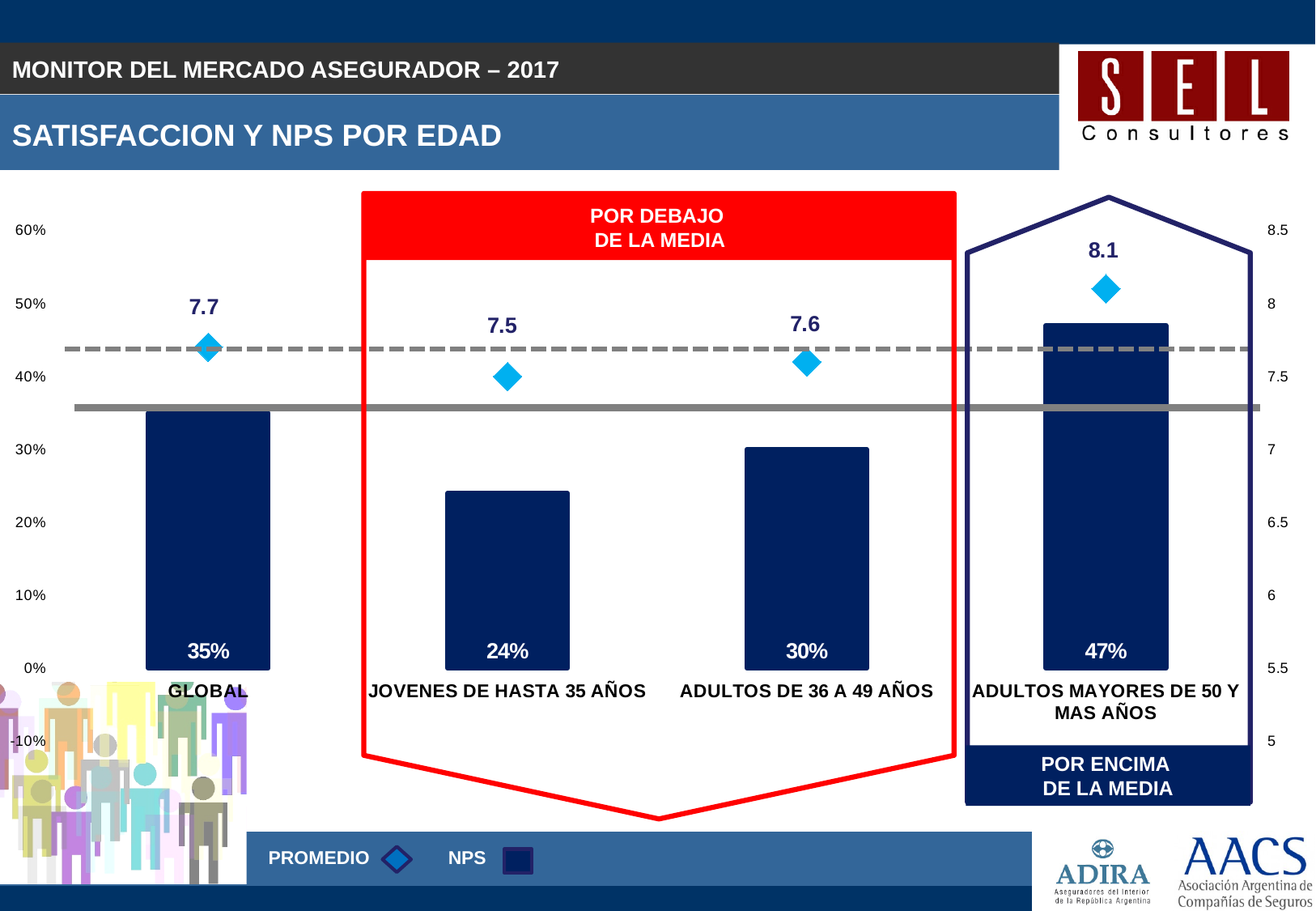
What is the PROMEDIO value for ADULTOS MAYORES DE 50 Y MAS AÑOS? 8.1 Which has a higher NPS, ADULTOS DE 36 A 49 AÑOS or GLOBAL? GLOBAL What is the difference in NPS between ADULTOS MAYORES DE 50 Y MAS AÑOS and JOVENES DE HASTA 35 AÑOS? 23% Which series is shown with diamond markers according to the legend? PROMEDIO What is the NPS value for JOVENES DE HASTA 35 AÑOS? 24% Which category has the highest NPS? ADULTOS MAYORES DE 50 Y MAS AÑOS Which category has the lowest PROMEDIO? JOVENES DE HASTA 35 AÑOS How many series does the legend list? 2 How many categories are shown on the x axis? 4 What is the difference in PROMEDIO between GLOBAL and JOVENES DE HASTA 35 AÑOS? 0.2 What is the PROMEDIO value for ADULTOS DE 36 A 49 AÑOS? 7.6 What is the NPS value for GLOBAL? 35%